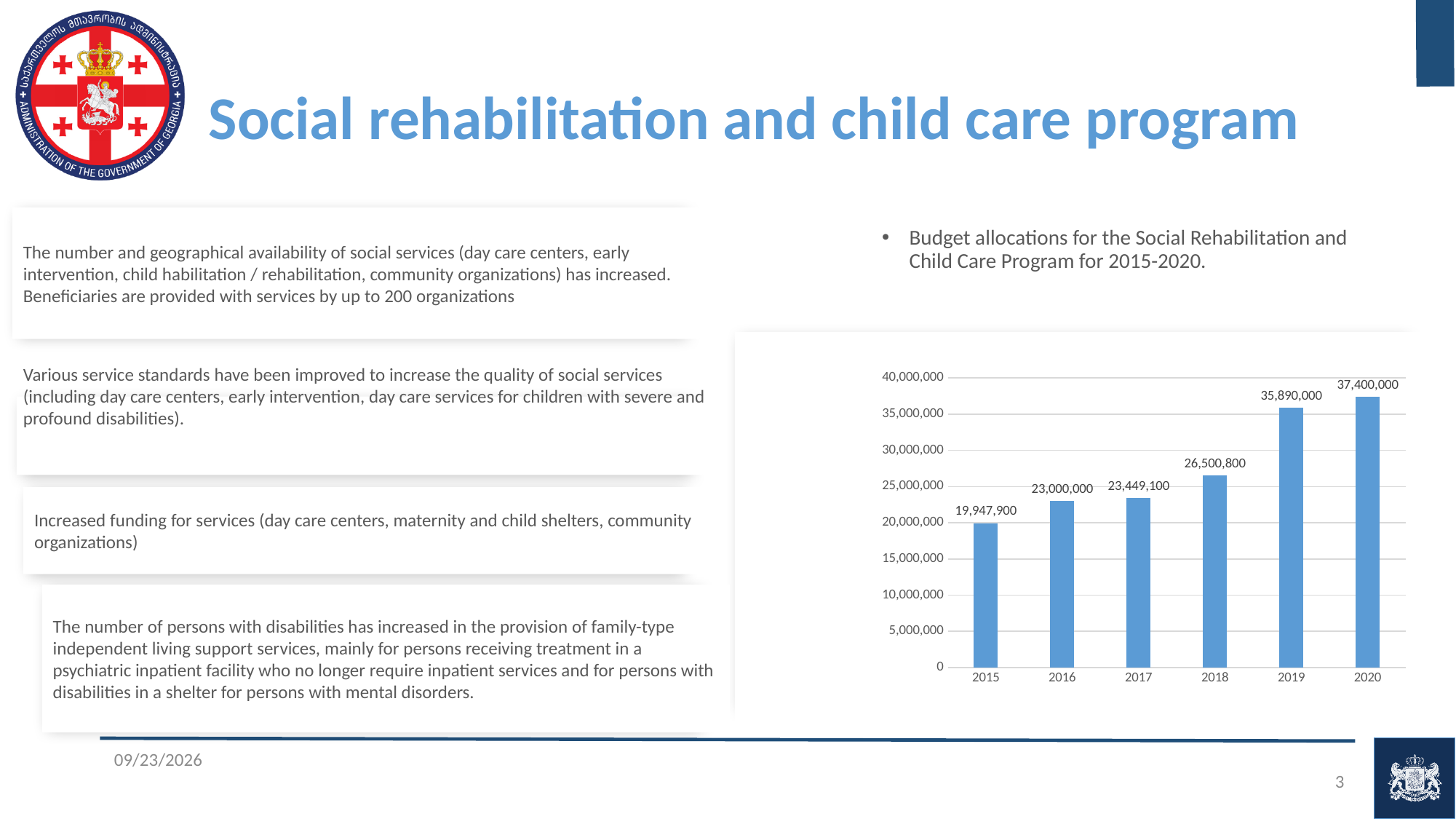
Do the budget allocations rise or fall from 2015 to 2020? Rise Is the value for 2019 greater or less than 30,000,000? greater Which year has the highest budget allocation in the chart? 2020 How many years are shown on the x axis of the chart? 6 Which year has the lowest budget allocation in the chart? 2015 What is the budget allocation shown for 2015? 19,947,900 Which year has a larger budget allocation, 2018 or 2017? 2018 What is the difference between the budget allocations for 2020 and 2019? 1,510,000 What kind of chart is used to show the budget allocations? Bar chart What is the difference between the budget allocations for 2017 and 2016? 449,100 What is the budget allocation shown for 2018? 26,500,800 What is the budget allocation shown for 2020? 37,400,000